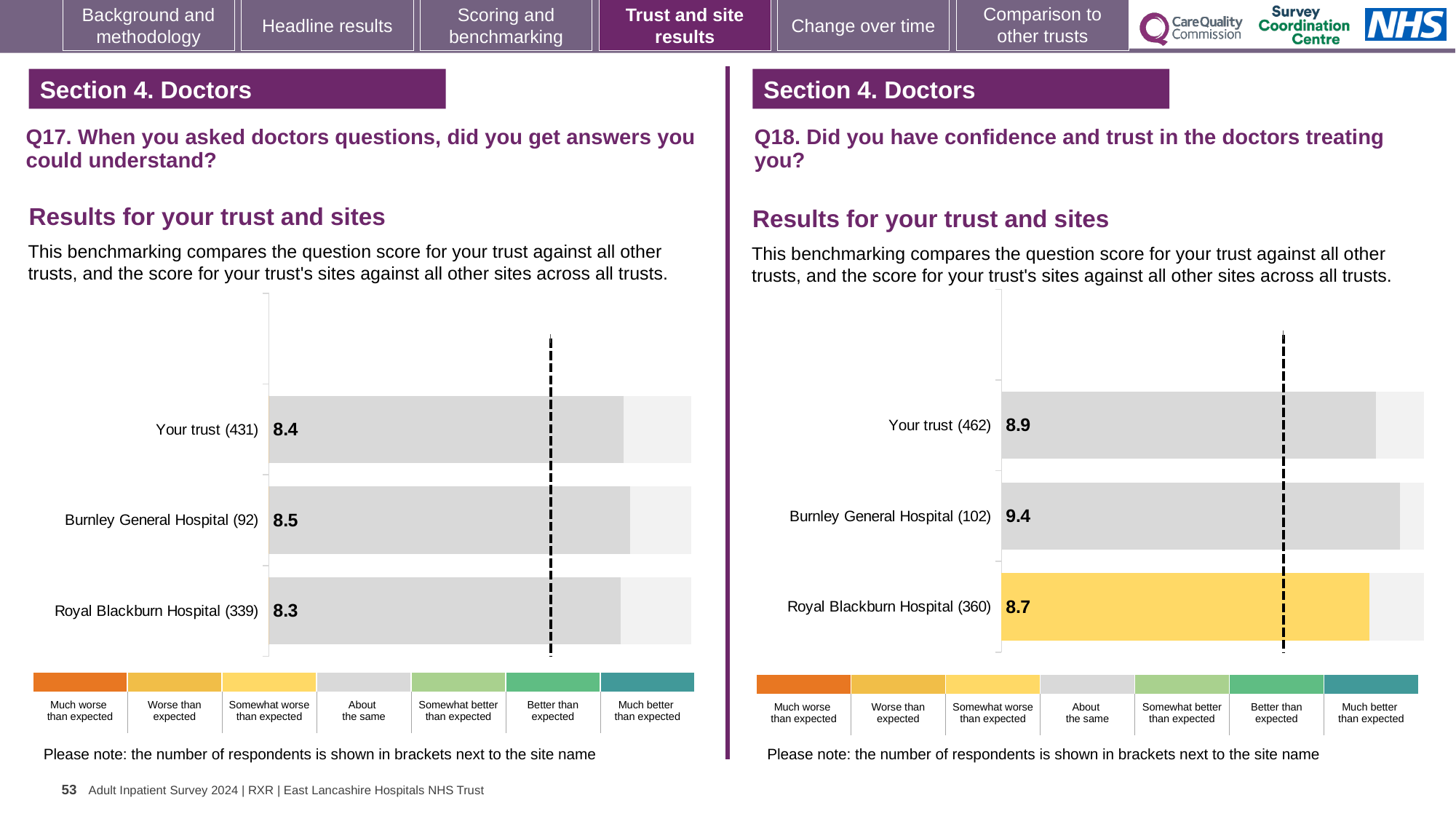
In the Q18 chart on the right, what is the difference between the scores for Burnley General Hospital and Your trust? 0.5 In the Q17 chart on the left, what is the score for Royal Blackburn Hospital? 8.3 In the Q17 chart on the left, what is the difference between the scores for Burnley General Hospital and Royal Blackburn Hospital? 0.2 In the Q18 chart on the right, which site or trust has the lowest score? Royal Blackburn Hospital In the Q17 chart on the left, what is the score for Your trust? 8.4 In the Q18 chart on the right, what is the score for Burnley General Hospital? 9.4 In the Q17 chart on the left, how many bars are plotted? 3 In the Q18 chart on the right, what is the score for Your trust? 8.9 In the Q17 chart on the left, which site or trust has the highest score? Burnley General Hospital In the Q18 chart on the right, how many respondents are shown in brackets for Royal Blackburn Hospital? 360 In the Q18 chart on the right, which has the larger score, Your trust or Royal Blackburn Hospital? Your trust What type of chart is used on this slide? Bar chart